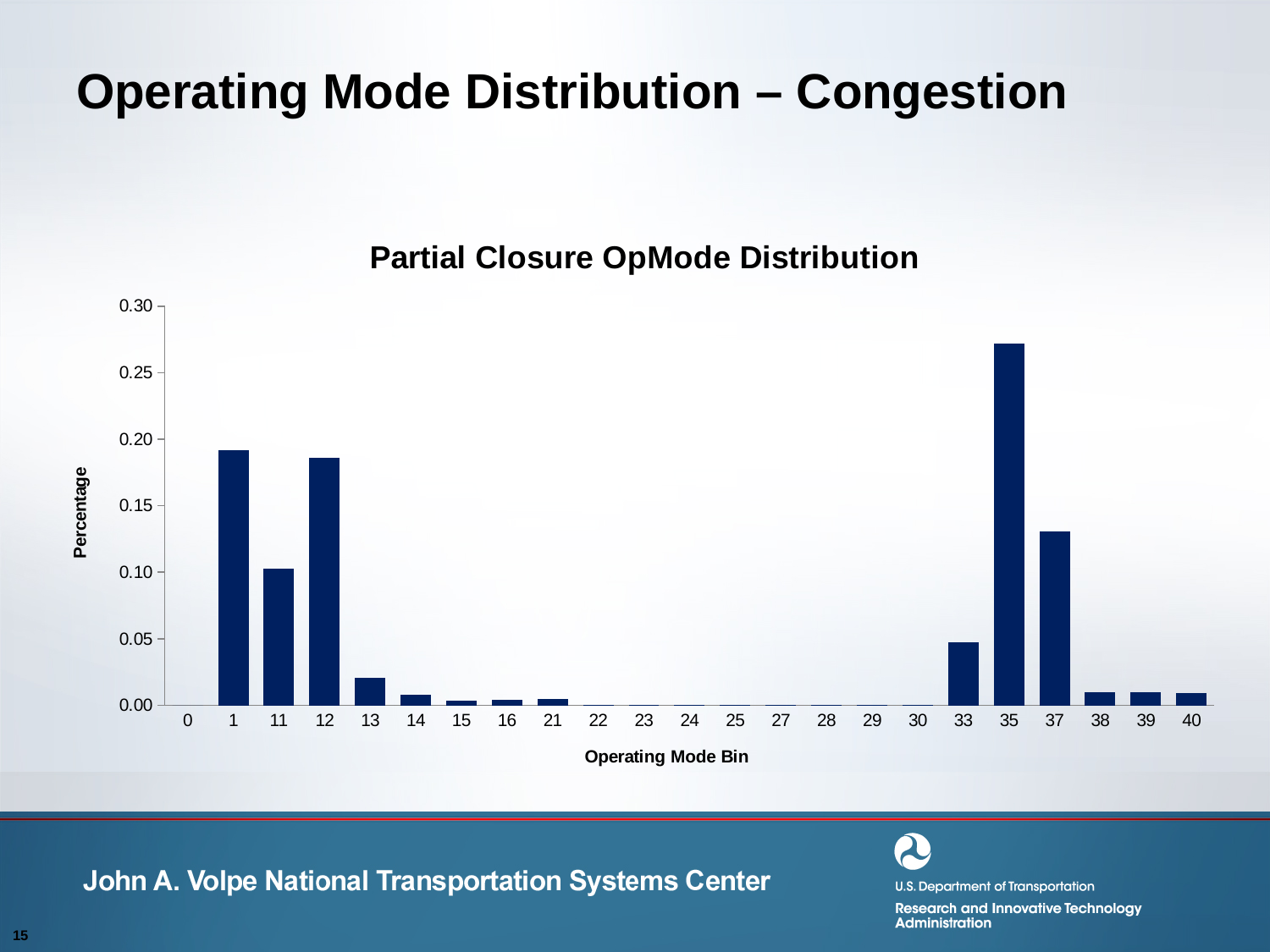
Which operating mode bin has the highest percentage? 35 Is the value for bin 35 greater or less than 0.25? greater Is the value for bin 1 greater or less than 0.20? less How many operating mode bins are shown on the x axis? 23 Which has a higher percentage, bin 35 or bin 1? 35 Is the value for bin 37 greater or less than 0.10? greater Which has a higher percentage, bin 33 or bin 13? 33 What kind of chart is shown on the slide? bar chart What is the label of the x axis? Operating Mode Bin Which has a higher percentage, bin 11 or bin 37? 37 What is the title of the chart? Partial Closure OpMode Distribution